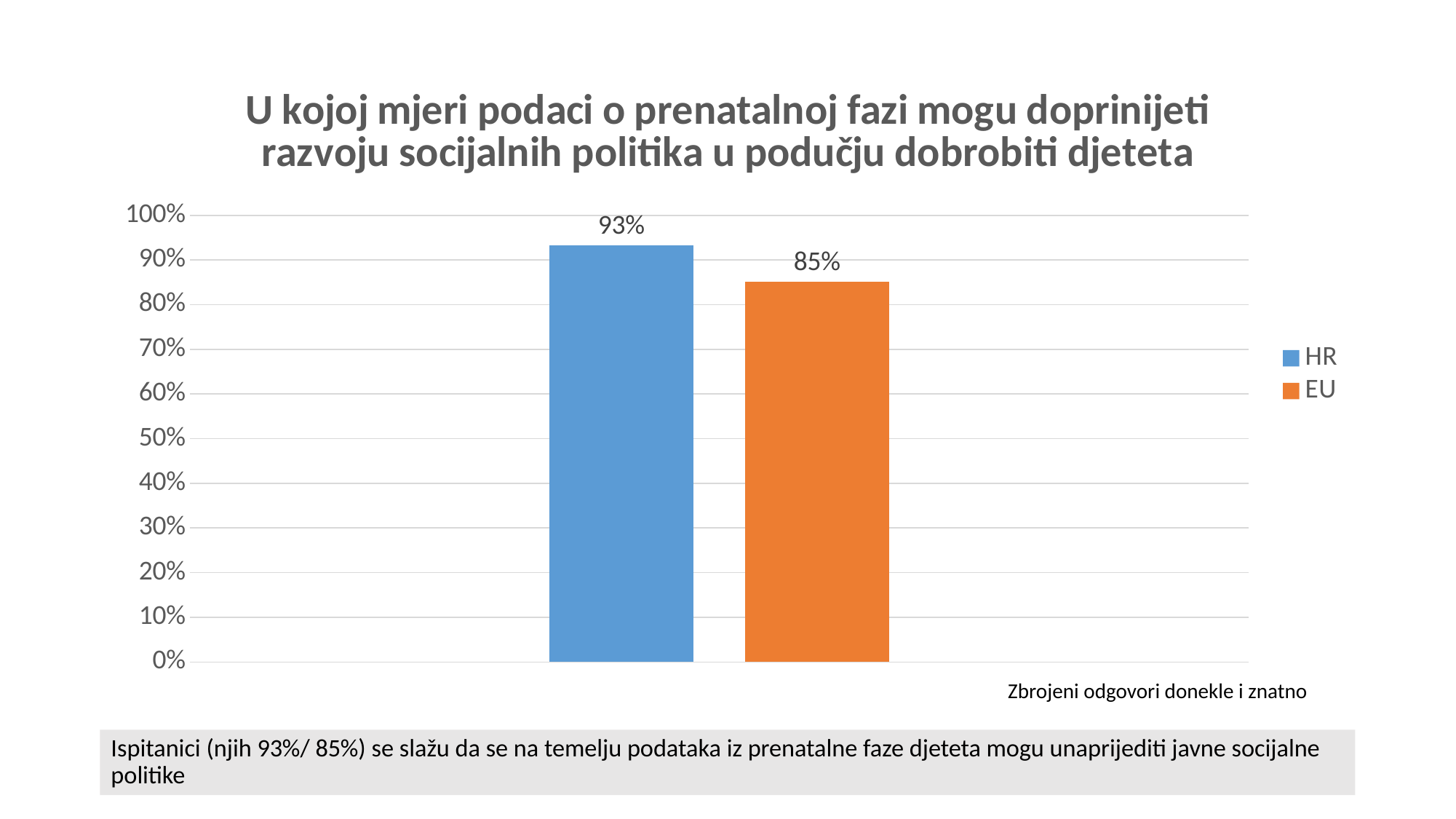
Which series has the higher value, HR or EU? HR How many bars are plotted in the chart? 2 Which series has the lowest value? EU How many series does the legend list? 2 What kind of chart is shown on the slide? bar chart What is the value for HR? 93% What is the value for EU? 85% What is the difference between the HR and EU values? 8% Is the value for EU greater or less than 90%? less What is the maximum value shown on the vertical axis? 100% What colour is the bar for EU? orange Is the value for HR greater or less than 90%? greater